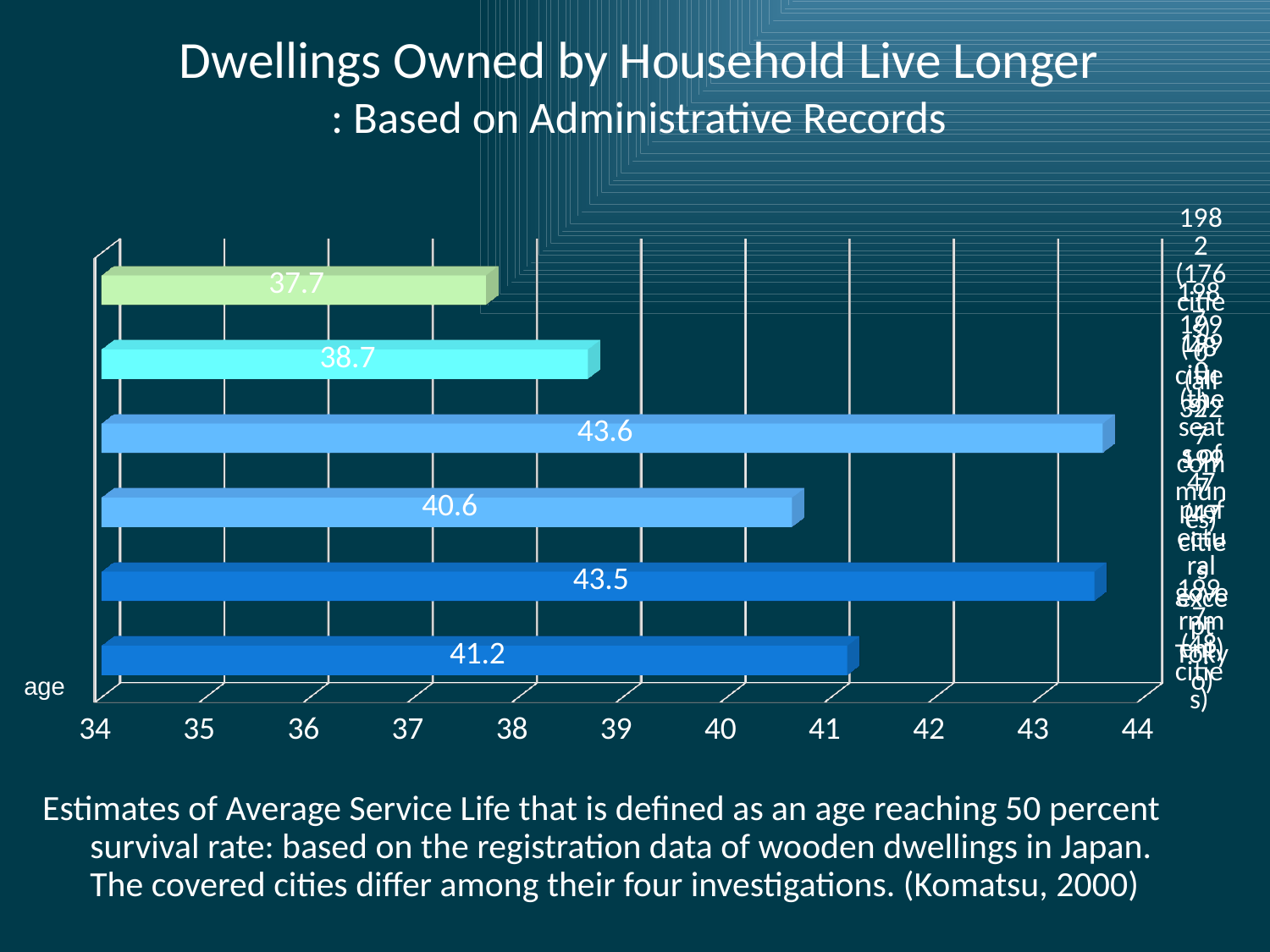
What is the difference between the highest bar value (43.6) and the lowest bar value (37.7)? 5.9 Which is larger, the value of the top bar or the value of the bottom bar? the bottom bar What is the value shown on the second bar from the top? 38.7 What label is shown on the horizontal axis of the chart? age Is the value of the top bar greater or less than 38? less What is the lowest value plotted in the chart? 37.7 What is the highest value plotted in the chart? 43.6 What is the value shown on the top bar of the chart? 37.7 What is the value shown on the fourth bar from the top? 40.6 What kind of chart is shown on the slide? bar chart What is the value shown on the bottom bar of the chart? 41.2 How many bars are plotted in the chart? 6